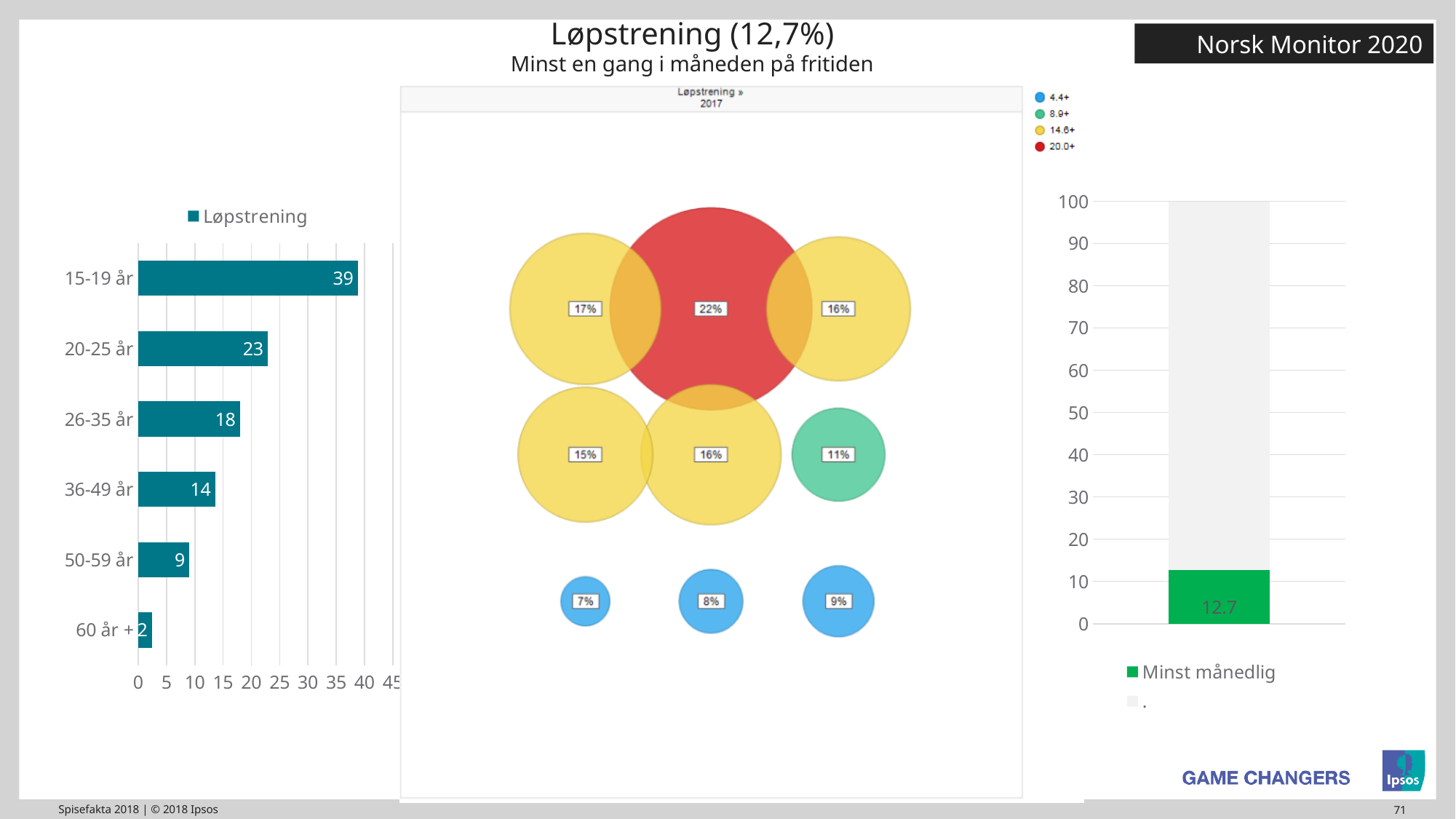
What kind of chart is the chart on the left of the slide? bar chart In the right bar chart, is the value for Minst månedlig greater or less than 20? less In the left bar chart, how many age groups are shown? 6 In the left bar chart, which age group has the highest value? 15-19 år In the left bar chart, do the values rise or fall as the age groups get older from top to bottom? fall In the left bar chart, which age group has the lowest value? 60 år + In the left bar chart, what is the difference between the values for 20-25 år and 26-35 år? 5 In the right bar chart, what is the value for Minst månedlig? 12.7 In the left bar chart, what is the value for the 15-19 år age group? 39 In the left bar chart, what is the value for the 36-49 år age group? 14 In the middle bubble chart, what is the highest percentage shown in any bubble? 22% How many entries does the legend of the middle bubble chart list? 4